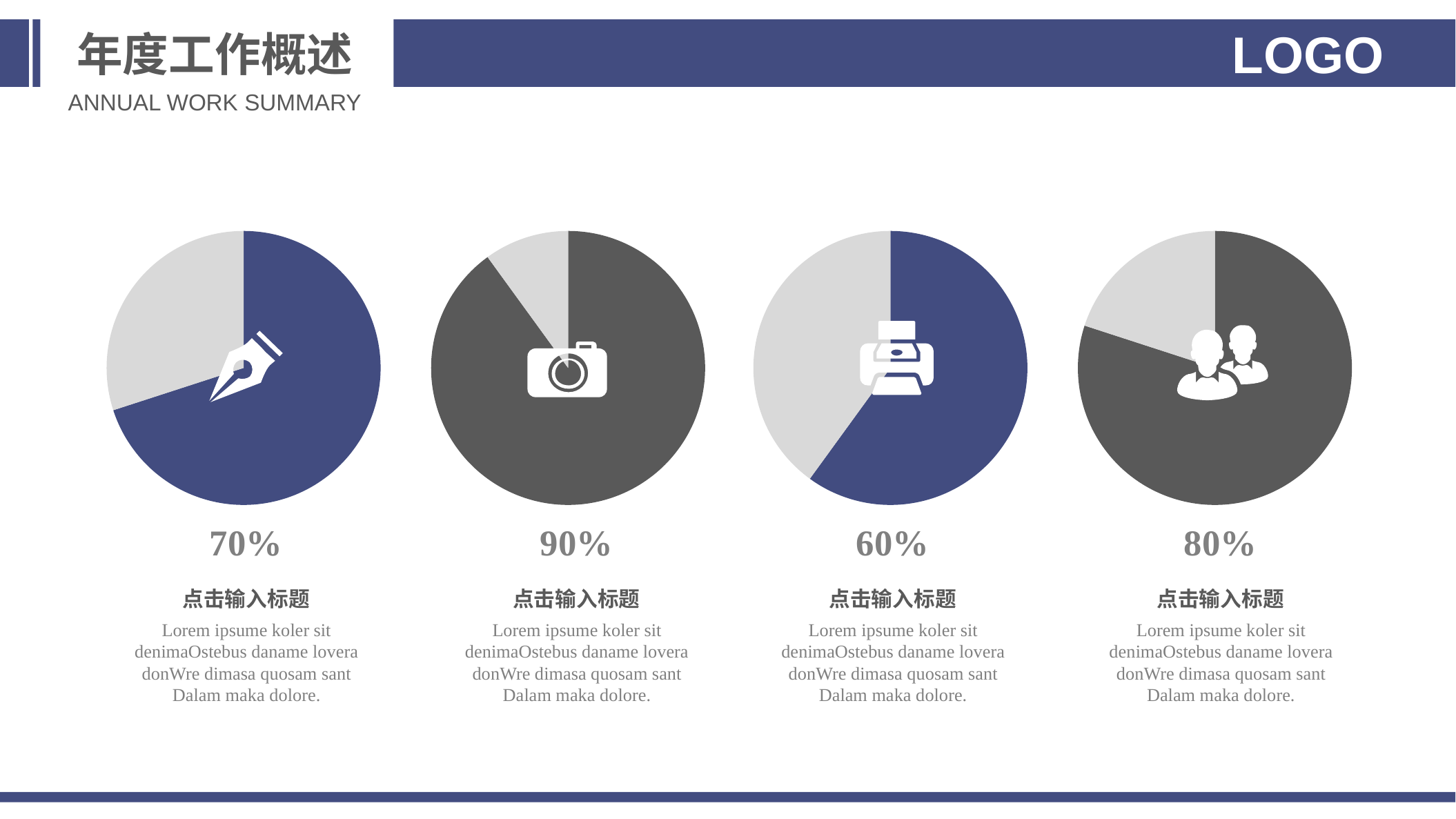
What percentage is shown below the rightmost pie chart (with the people icon)? 80% Which of the four pie charts shows the lowest percentage? The third from the left (printer icon), 60% How many pie charts are on the slide? 4 What type of chart is used for each of the four figures on the slide? Pie chart What colour is the filled (larger) slice of the rightmost pie chart? Dark grey Which of the four pie charts shows the highest percentage? The second from the left (camera icon), 90% What percentage is shown below the third pie chart from the left (with the printer icon)? 60% What percentage is shown below the leftmost pie chart (with the pen nib icon)? 70% What colour is the filled (larger) slice of the leftmost pie chart? Blue What is the difference between the percentage of the second pie chart (90%) and the third pie chart (60%)? 30% What percentage is shown below the second pie chart from the left (with the camera icon)? 90% Which is larger: the percentage of the leftmost pie chart or the rightmost pie chart? The rightmost (80%)